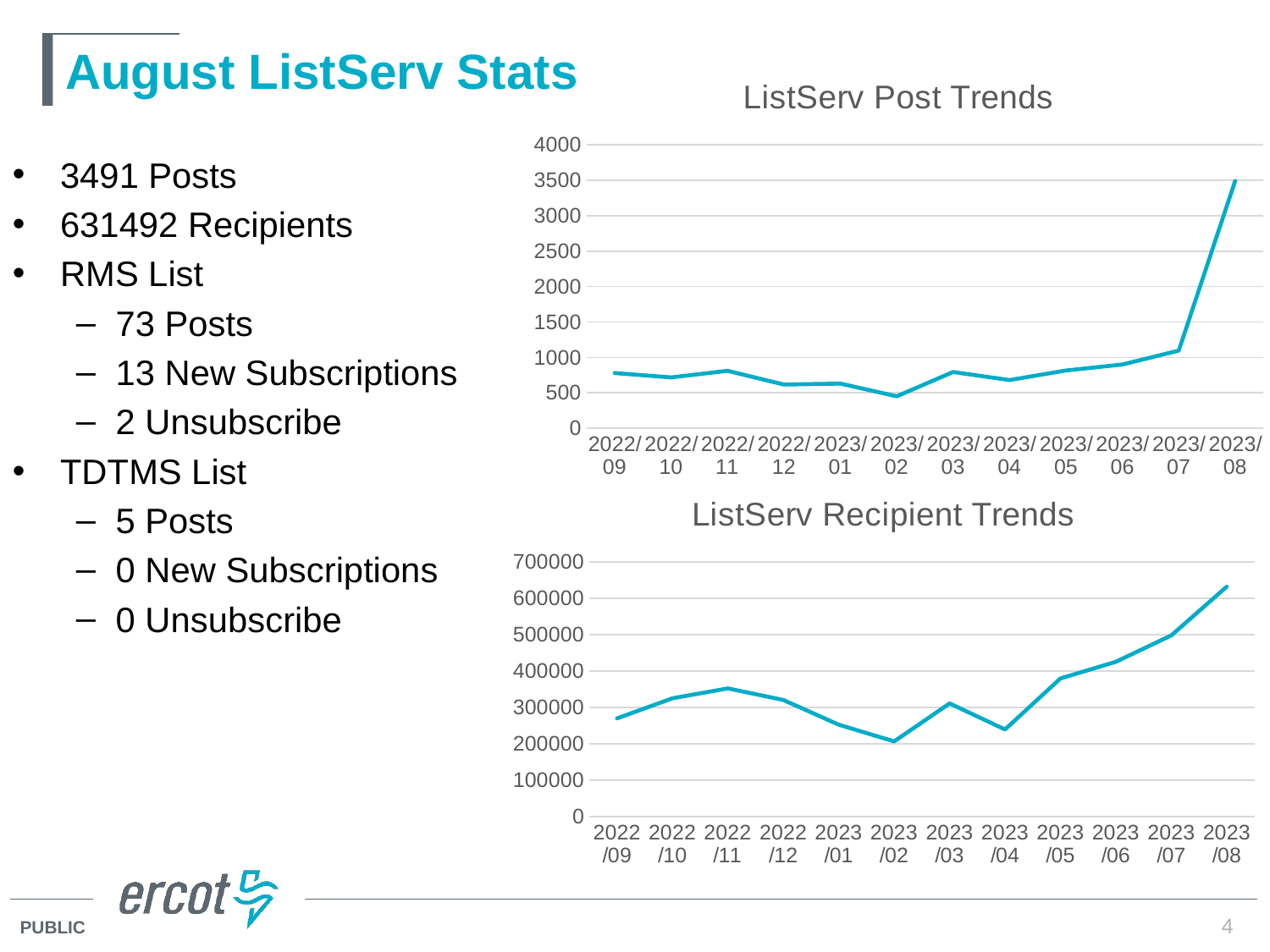
In the ListServ Recipient Trends chart, which is larger, the value for 2022/11 or the value for 2023/04? 2022/11 In the ListServ Recipient Trends chart, which month has the lowest number of recipients? 2023/02 In the ListServ Post Trends chart, is the value for 2023/02 greater or less than 500? less In the ListServ Recipient Trends chart, which month has the highest number of recipients? 2023/08 In the ListServ Post Trends chart, which month has the highest number of posts? 2023/08 What kind of chart is the ListServ Recipient Trends chart? line chart In the ListServ Post Trends chart, how many months are plotted along the x axis? 12 In the ListServ Recipient Trends chart, do the values rise or fall from 2023/04 to 2023/08? rise What kind of chart is the ListServ Post Trends chart? line chart In the ListServ Post Trends chart, is the value for 2023/08 greater or less than 3000? greater In the ListServ Post Trends chart, which month has the lowest number of posts? 2023/02 In the ListServ Recipient Trends chart, is the value for 2023/08 greater or less than 600000? greater